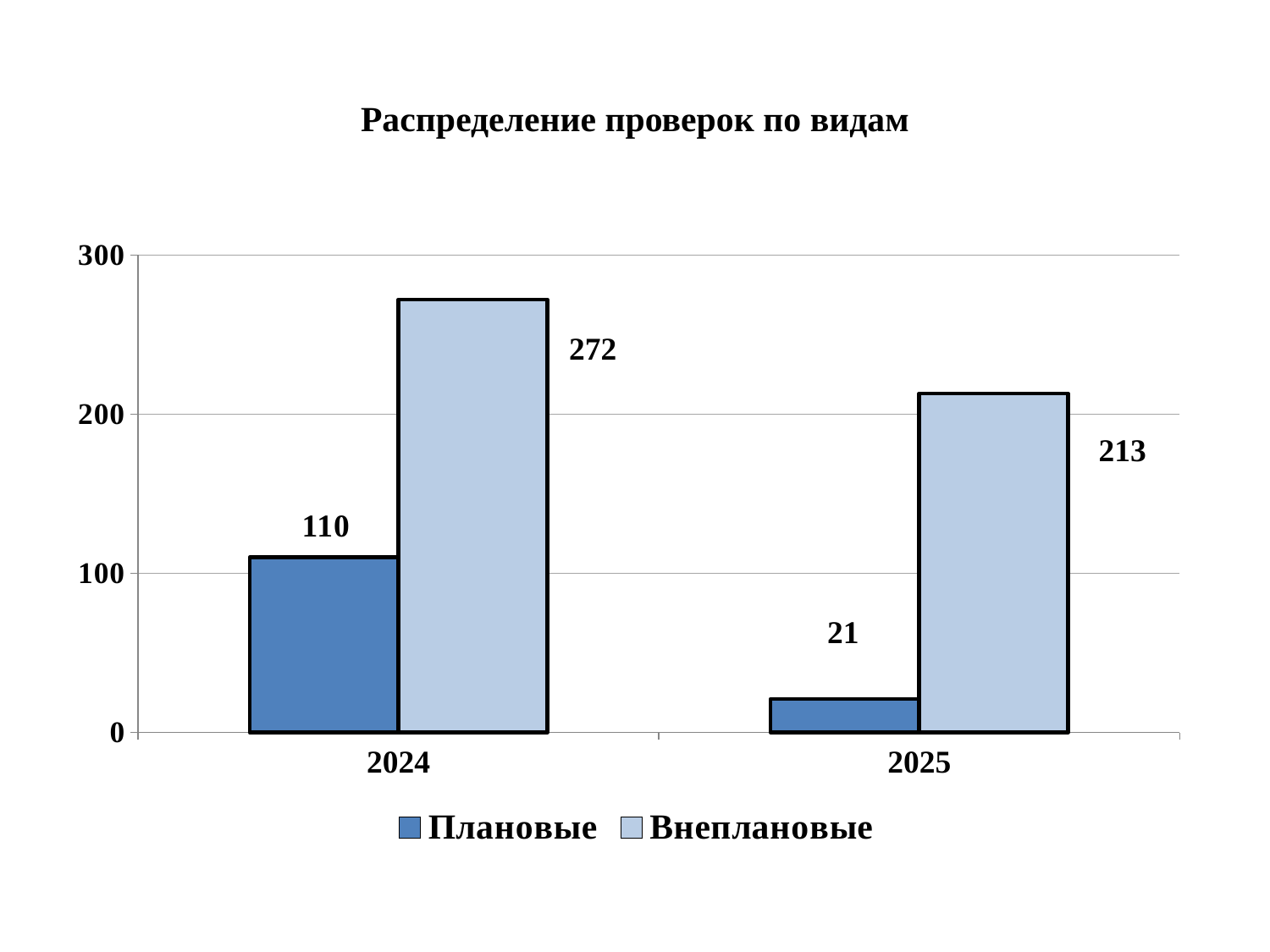
Which is larger in 2025, Плановые or Внеплановые? Внеплановые Which year has the highest value for Внеплановые? 2024 Which year has the lowest value for Плановые? 2025 What is the difference between Внеплановые and Плановые in 2024? 162 What is the difference between Внеплановые in 2024 and Внеплановые in 2025? 59 What is the title of the chart? Распределение проверок по видам What is the value for Плановые in 2025? 21 How many series does the legend list? 2 What is the value for Внеплановые in 2025? 213 What kind of chart is this? bar chart How many years are shown on the x axis? 2 What is the value for Плановые in 2024? 110